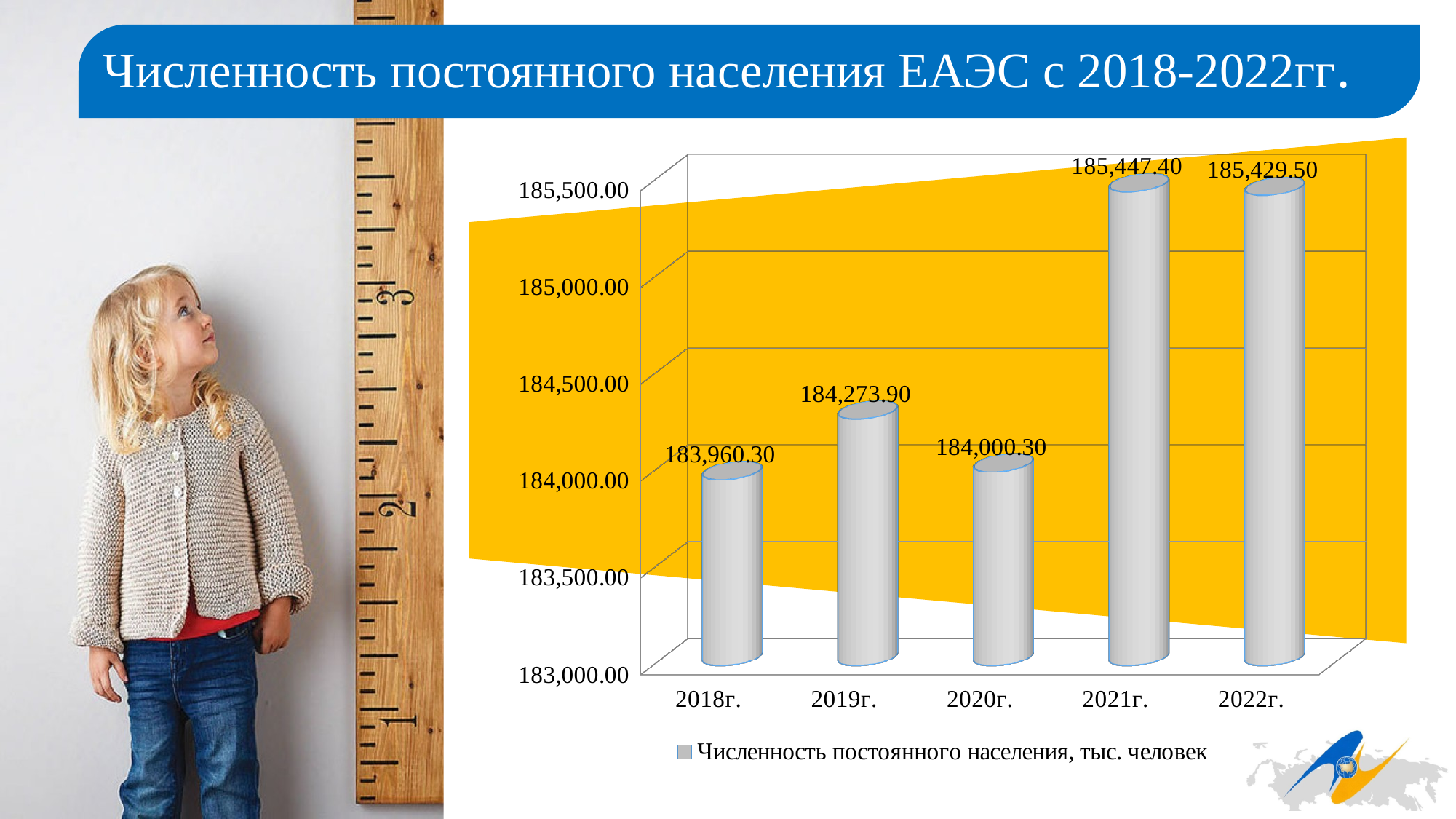
Which year has the highest value? 2021г. Which year has the lowest value? 2018г. What is the value for 2020г.? 184,000.30 How many series does the legend list? 1 What is the value for 2021г.? 185,447.40 What is the difference between the values for 2019г. and 2018г.? 313.60 What is the value for 2018г.? 183,960.30 What is the difference between the values for 2021г. and 2022г.? 17.90 Which is larger, the value for 2019г. or the value for 2020г.? 2019г. What kind of chart is shown on the slide? Bar chart What is the legend entry of the chart? Численность постоянного населения, тыс. человек How many years are shown on the x axis? 5